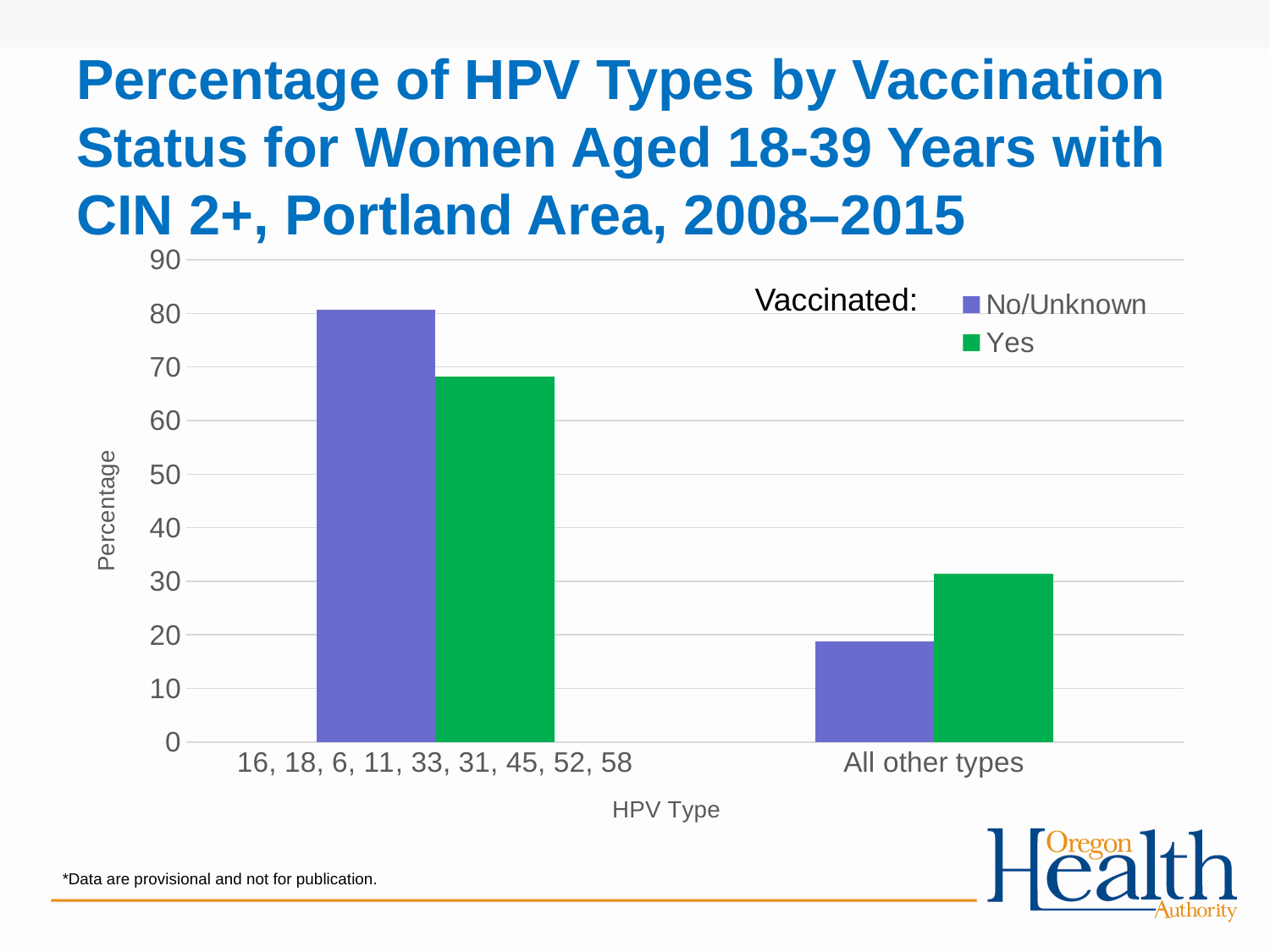
How many HPV type categories are shown on the x axis? 2 Which series has the higher value for "All other types": No/Unknown or Yes? Yes Is the No/Unknown value for "All other types" greater or less than 20? less Which bar is the tallest in the chart? No/Unknown for 16, 18, 6, 11, 33, 31, 45, 52, 58 How many series does the legend list? 2 Is the Yes value for "All other types" greater or less than 30? greater What is the label of the y axis? Percentage Which series has the higher value for the category "16, 18, 6, 11, 33, 31, 45, 52, 58": No/Unknown or Yes? No/Unknown What kind of chart is shown on the slide? bar chart Is the Yes value for "16, 18, 6, 11, 33, 31, 45, 52, 58" greater or less than 70? less Which bar is the shortest in the chart? No/Unknown for All other types